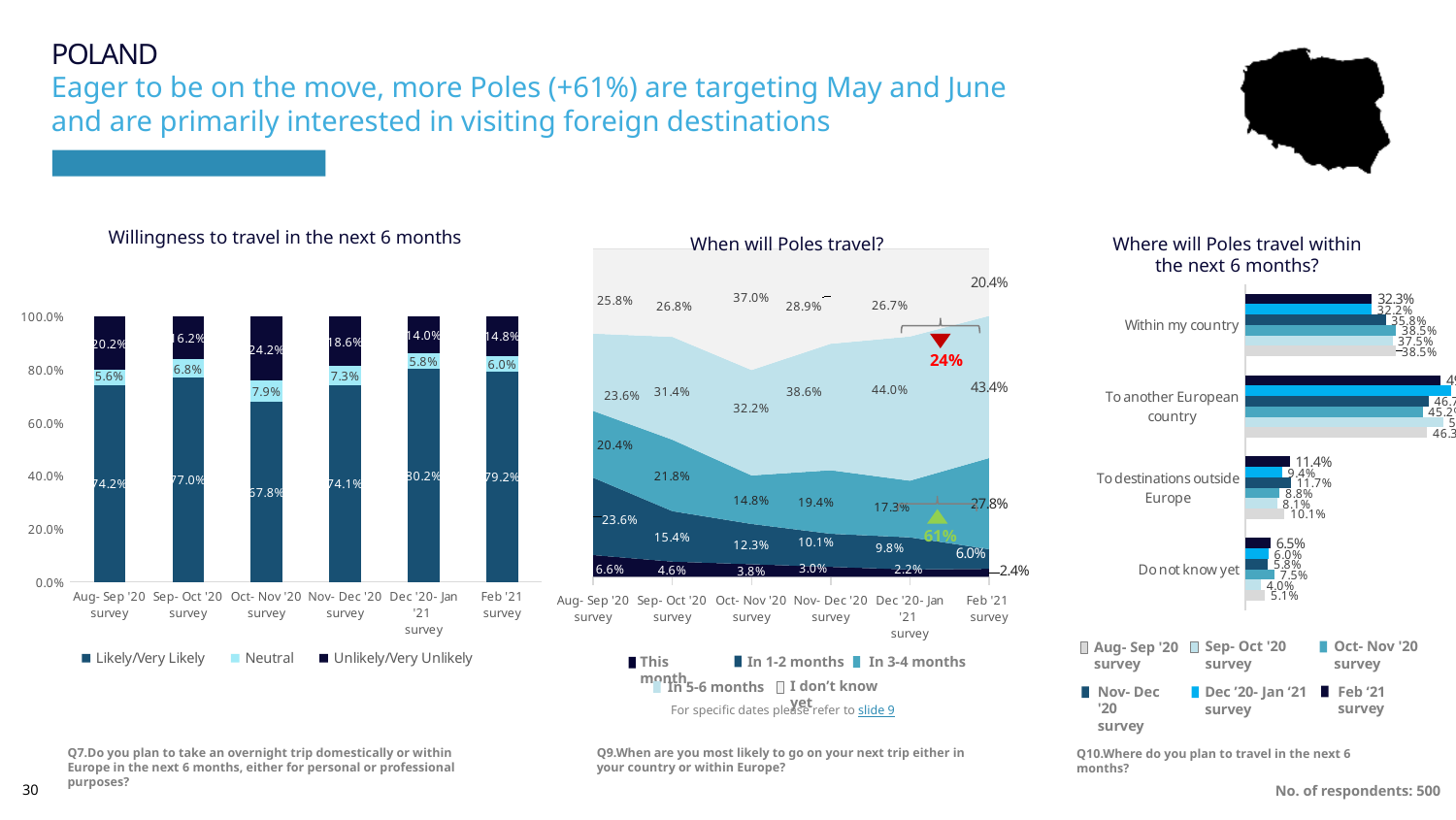
How many categories are shown in the 'Where will Poles travel within the next 6 months?' chart? 4 In the 'Willingness to travel in the next 6 months' chart, what is the Neutral value for the Oct- Nov '20 survey? 7.9% How many series does the legend of the 'Willingness to travel in the next 6 months' chart list? 3 In the 'Willingness to travel in the next 6 months' chart, what is the difference between the Unlikely/Very Unlikely values for the Aug- Sep '20 survey and the Feb '21 survey? 5.4% In the 'Willingness to travel in the next 6 months' chart, what is the Likely/Very Likely value for the Feb '21 survey? 79.2% In the 'When will Poles travel?' chart, what is the 'In 5-6 months' value for the Dec '20- Jan '21 survey? 44.0% In the 'When will Poles travel?' chart, what is the 'This month' value for the Feb '21 survey? 2.4% In the 'Where will Poles travel within the next 6 months?' chart, what is the Feb '21 survey value for 'To destinations outside Europe'? 11.4% In the 'When will Poles travel?' chart, does the 'This month' value rise or fall from the Aug- Sep '20 survey to the Dec '20- Jan '21 survey? Fall In the 'Willingness to travel in the next 6 months' chart, which survey has the highest Likely/Very Likely value? Dec '20- Jan '21 survey What type of chart is 'When will Poles travel?' Stacked area chart In the 'Willingness to travel in the next 6 months' chart, which survey has the lowest Likely/Very Likely value? Oct- Nov '20 survey